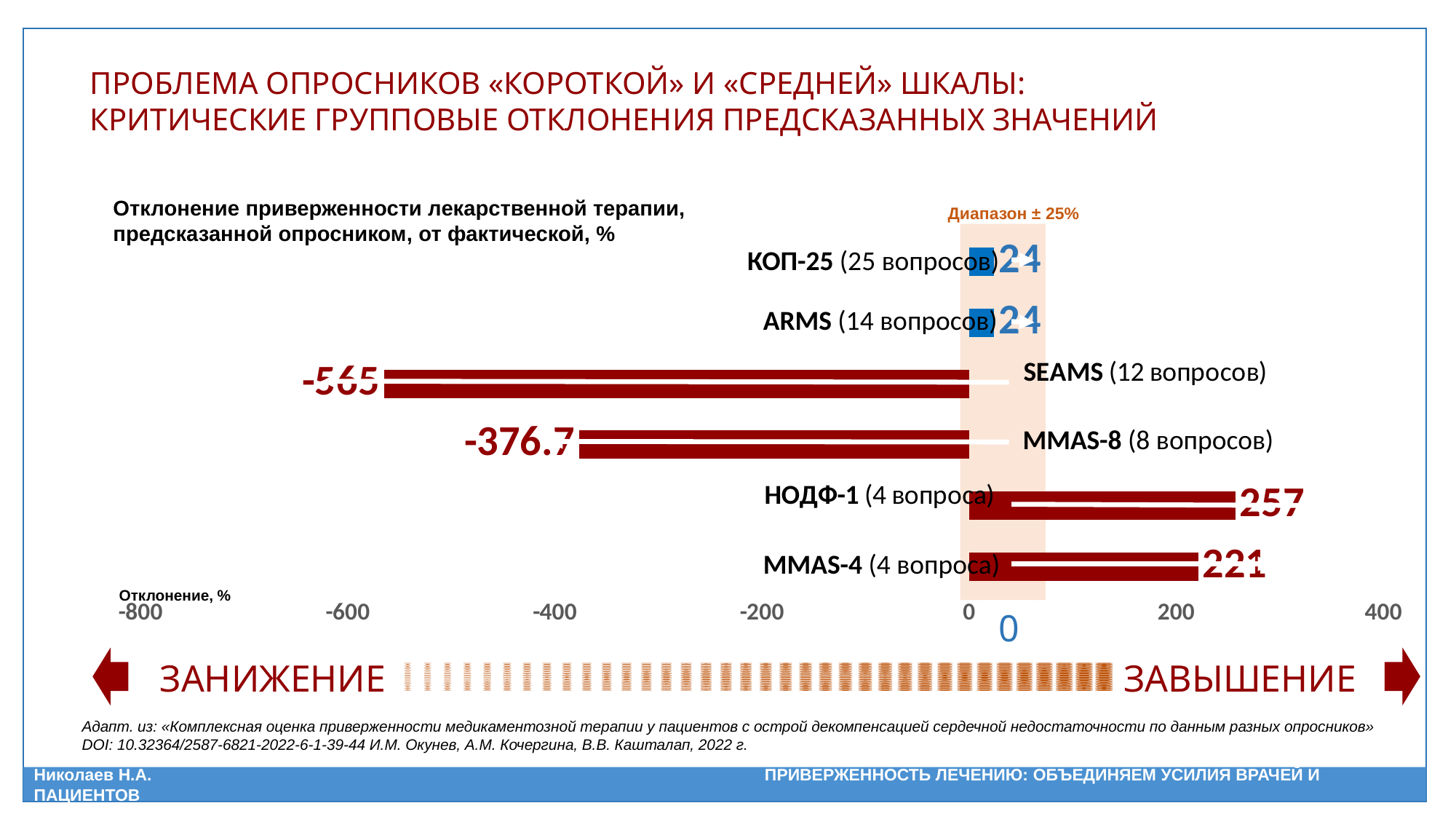
How many questionnaires (categories) are plotted in the chart? 6 What is the difference between the deviation values of НОДФ-1 (4 вопроса) and MMAS-4 (4 вопроса)? 36 Which has a larger deviation value, НОДФ-1 (4 вопроса) or MMAS-4 (4 вопроса)? НОДФ-1 (4 вопроса) Which questionnaire has the lowest (most negative) deviation value? SEAMS (12 вопросов) What is the deviation value for SEAMS (12 вопросов)? -565 What is the deviation value for НОДФ-1 (4 вопроса)? 257 What type of chart is shown on the slide? bar chart Which questionnaire has the highest (most positive) deviation value? НОДФ-1 (4 вопроса) What is the deviation value for MMAS-4 (4 вопроса)? 221 What is the deviation value for MMAS-8 (8 вопросов)? -376.7 What range is marked by the shaded band around zero in the chart? Диапазон ± 25% What is the deviation value for КОП-25 (25 вопросов)? 24